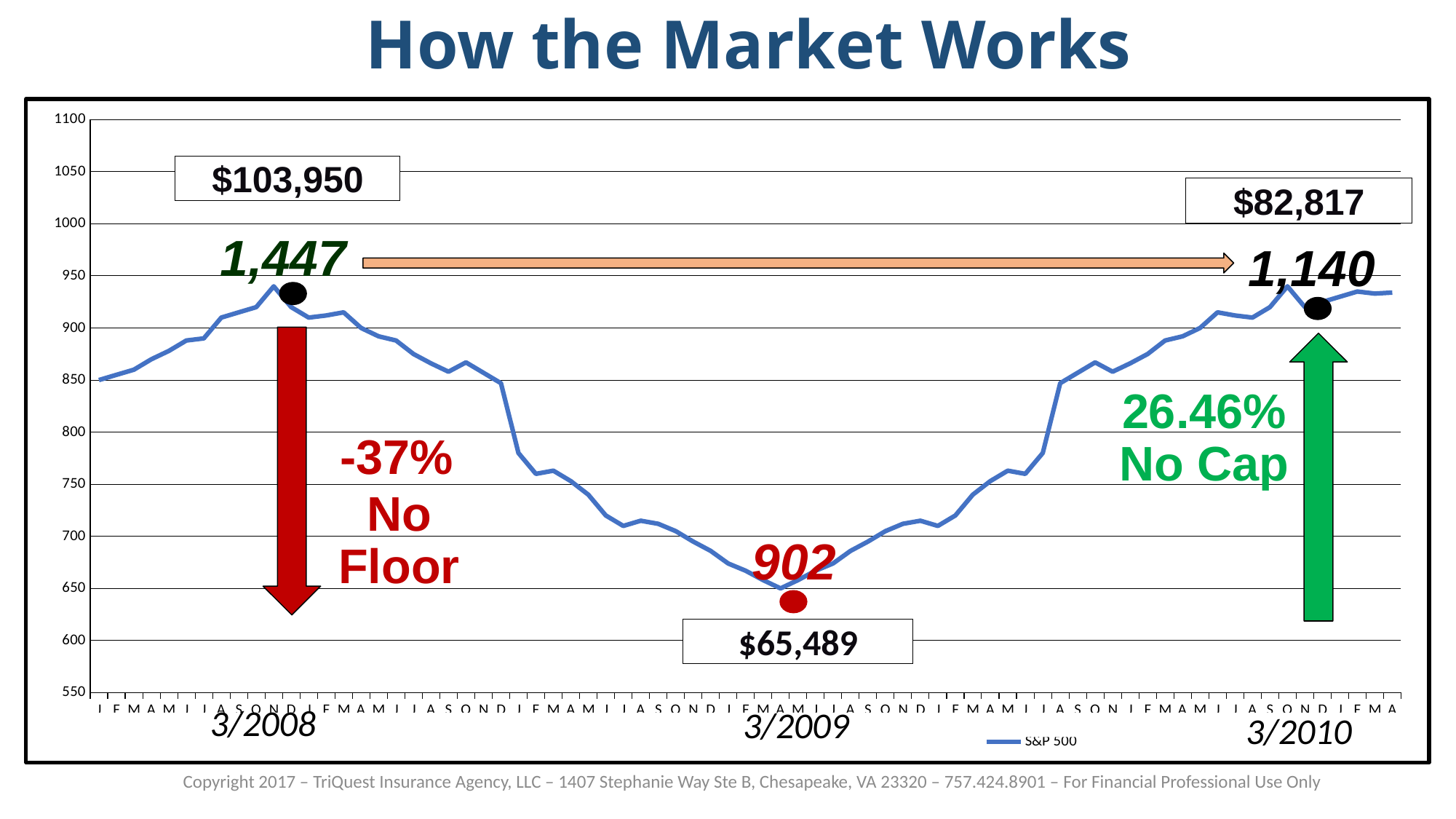
What S&P 500 value is labelled at 3/2009? 902 What S&P 500 value is labelled at 3/2010? 1,140 What series name appears in the legend? S&P 500 What dollar amount is shown in the box below the 3/2009 point? $65,489 Does the S&P 500 line rise or fall between 3/2009 and 3/2010? rise What percentage change is labelled next to the green upward arrow? 26.46% How many series does the legend list? 1 What dollar amount is shown in the box above the 3/2008 point? $103,950 Which of the three labelled dates has the lowest S&P 500 value? 3/2009 What kind of chart is shown on the slide? line chart What percentage change is labelled next to the red downward arrow? -37% What S&P 500 value is labelled at 3/2008? 1,447